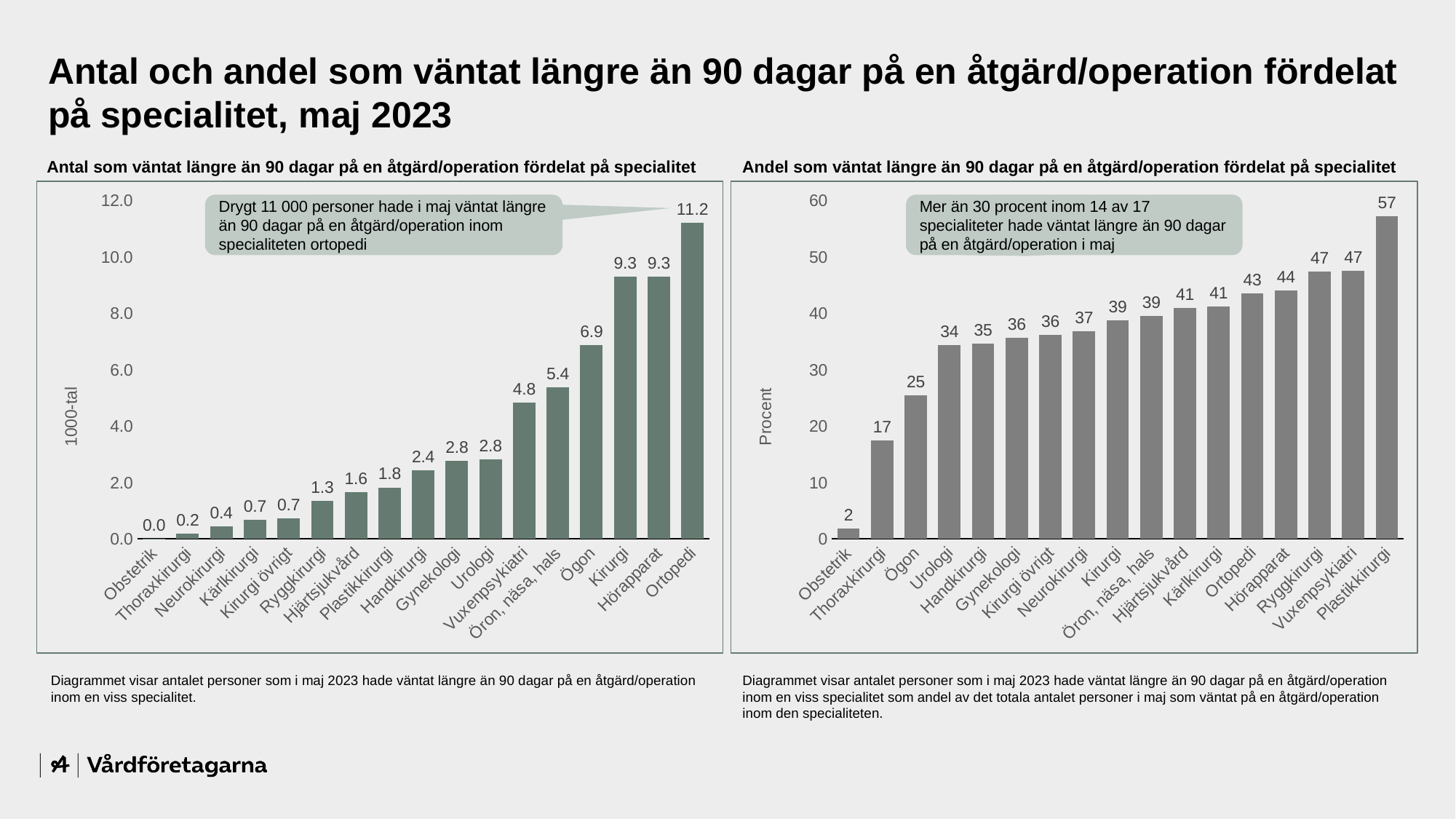
In the right chart (Andel som väntat längre än 90 dagar), what is the value for Thoraxkirurgi? 17 In the left chart (Antal som väntat längre än 90 dagar), what is the difference between Ögon and Öron, näsa, hals? 1.5 In the right chart (Andel som väntat längre än 90 dagar), what is the value for Plastikkirurgi? 57 In the left chart (Antal som väntat längre än 90 dagar), which specialty has the highest value? Ortopedi In the left chart (Antal som väntat längre än 90 dagar), how many specialties are shown? 17 In the left chart (Antal som väntat längre än 90 dagar), which specialty has the lowest value? Obstetrik In the left chart (Antal som väntat längre än 90 dagar), what is the value for Ortopedi? 11.2 In the left chart (Antal som väntat längre än 90 dagar), what is the value for Vuxenpsykiatri? 4.8 What type of chart is the right chart (Andel som väntat längre än 90 dagar)? bar chart In the right chart (Andel som väntat längre än 90 dagar), do the values rise or fall from left to right along the x axis? rise In the right chart (Andel som väntat längre än 90 dagar), which is larger, Ortopedi or Ögon? Ortopedi In the right chart (Andel som väntat längre än 90 dagar), what is the difference between Plastikkirurgi and Hörapparat? 13